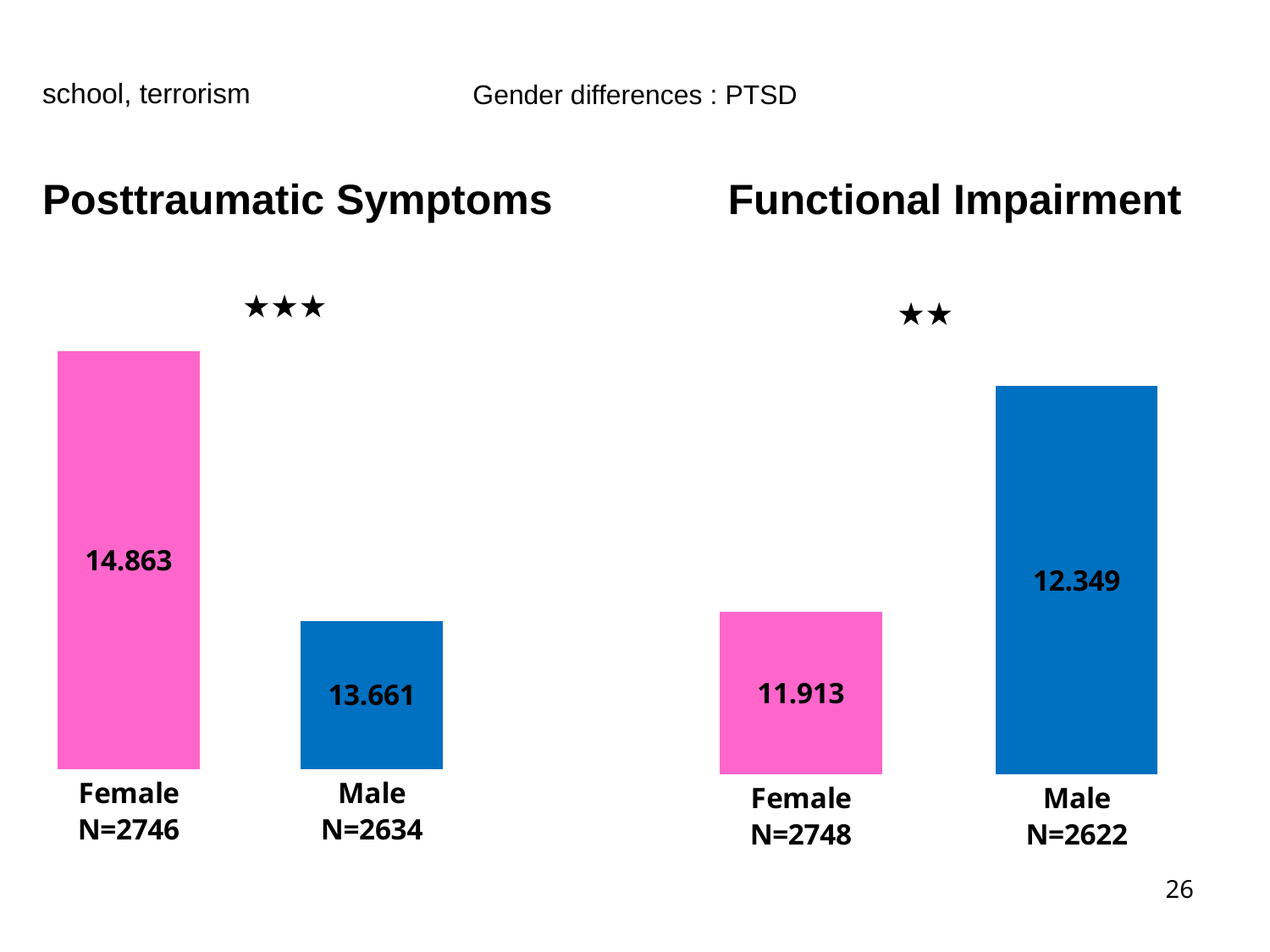
In the Functional Impairment chart, what is the difference between the Male and Female values? 0.436 In the Posttraumatic Symptoms chart, what is the difference between the Female and Male values? 1.202 In the Posttraumatic Symptoms chart, what is the value for Male? 13.661 In the Functional Impairment chart, is the value for Male larger or smaller than the value for Female? larger In the Functional Impairment chart, what is the value for Male? 12.349 What kind of chart is the Functional Impairment chart? bar chart In the Functional Impairment chart, which group has the lower value? Female In the Posttraumatic Symptoms chart, which group has the higher value? Female In the Posttraumatic Symptoms chart, what is the value for Female? 14.863 In the Functional Impairment chart, what is the value for Female? 11.913 How many bars are shown in the Posttraumatic Symptoms chart? 2 In the Posttraumatic Symptoms chart, what sample size (N) is shown for the Female group? N=2746